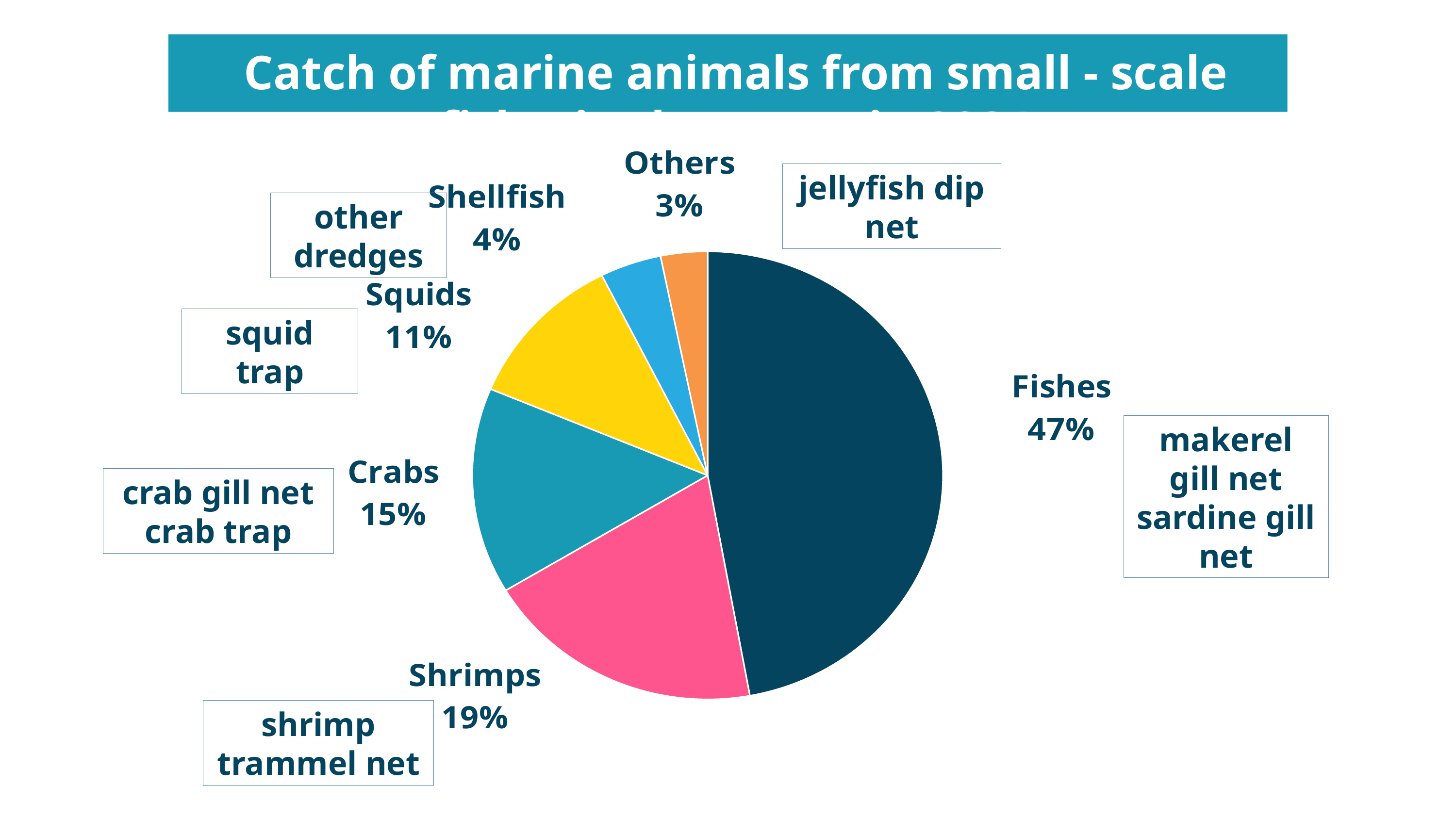
What percentage is shown for Shrimps? 19% What percentage is shown for Crabs? 15% How many percentage points larger is the Fishes share than the Shrimps share? 28 What share of the pie does Fishes account for? 47% What percentage is shown for Squids? 11% What kind of chart is shown on the slide? Pie chart Which is larger, the share for Crabs or the share for Squids? Crabs Which category has the smallest slice of the pie? Others How many categories are shown in the pie chart? 6 What colour is the Shrimps slice? Pink Which category has the largest slice of the pie? Fishes What percentage is shown for Shellfish? 4%